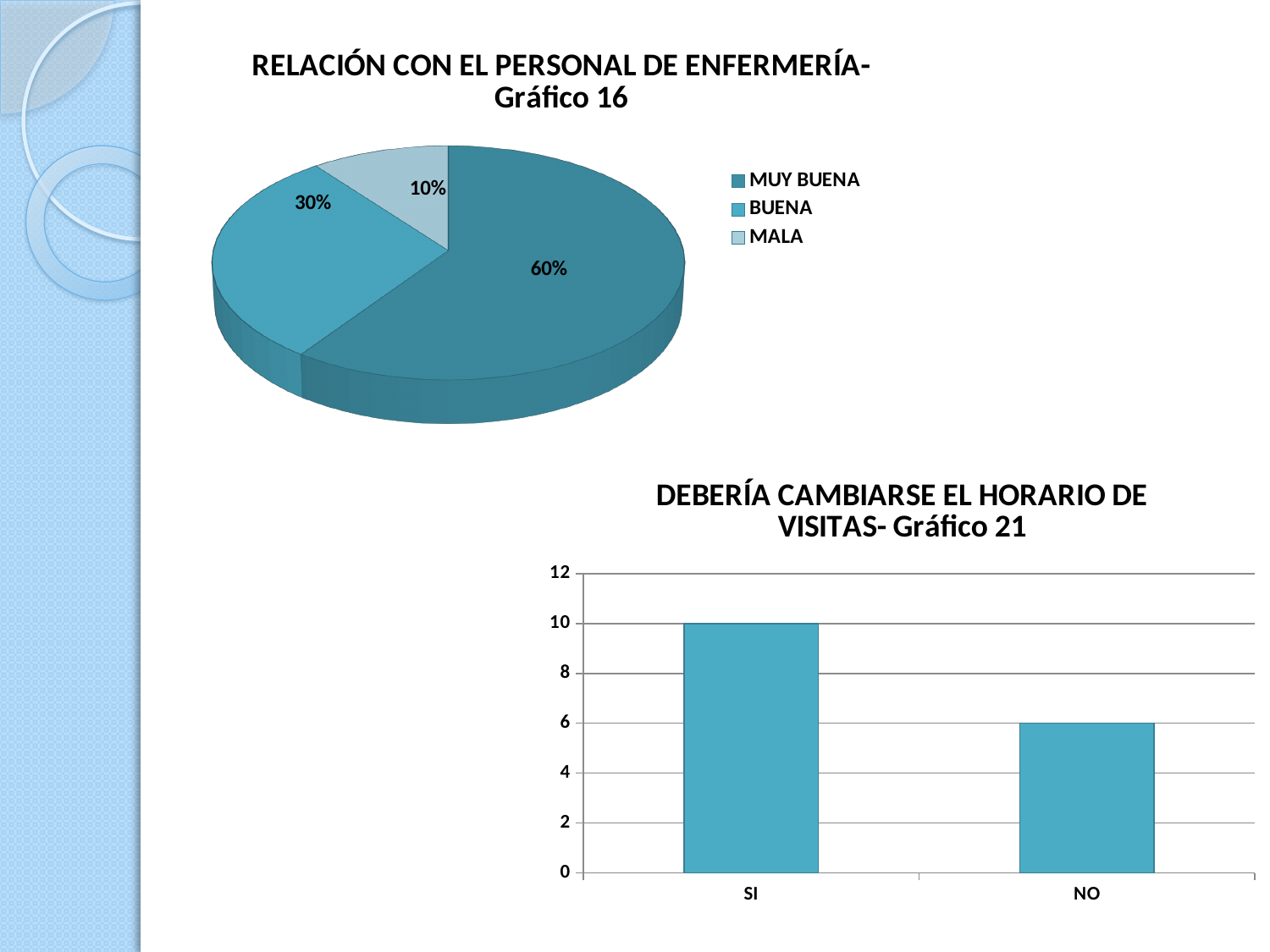
In the chart 'RELACIÓN CON EL PERSONAL DE ENFERMERÍA- Gráfico 16', which category has the largest slice? MUY BUENA In the chart 'RELACIÓN CON EL PERSONAL DE ENFERMERÍA- Gráfico 16', what share does MALA have? 10% In the chart 'RELACIÓN CON EL PERSONAL DE ENFERMERÍA- Gráfico 16', what share does BUENA have? 30% What kind of chart is 'DEBERÍA CAMBIARSE EL HORARIO DE VISITAS- Gráfico 21'? Bar chart In the chart 'RELACIÓN CON EL PERSONAL DE ENFERMERÍA- Gráfico 16', which category has the smallest slice? MALA In the chart 'RELACIÓN CON EL PERSONAL DE ENFERMERÍA- Gráfico 16', what share does MUY BUENA have? 60% In the chart 'RELACIÓN CON EL PERSONAL DE ENFERMERÍA- Gráfico 16', what is the difference between the MUY BUENA and BUENA shares? 30% In the chart 'DEBERÍA CAMBIARSE EL HORARIO DE VISITAS- Gráfico 21', what is the value for SI? 10 In the chart 'DEBERÍA CAMBIARSE EL HORARIO DE VISITAS- Gráfico 21', what is the value for NO? 6 In the chart 'DEBERÍA CAMBIARSE EL HORARIO DE VISITAS- Gráfico 21', what is the difference between SI and NO? 4 How many categories does the legend of 'RELACIÓN CON EL PERSONAL DE ENFERMERÍA- Gráfico 16' list? 3 What kind of chart is 'RELACIÓN CON EL PERSONAL DE ENFERMERÍA- Gráfico 16'? Pie chart